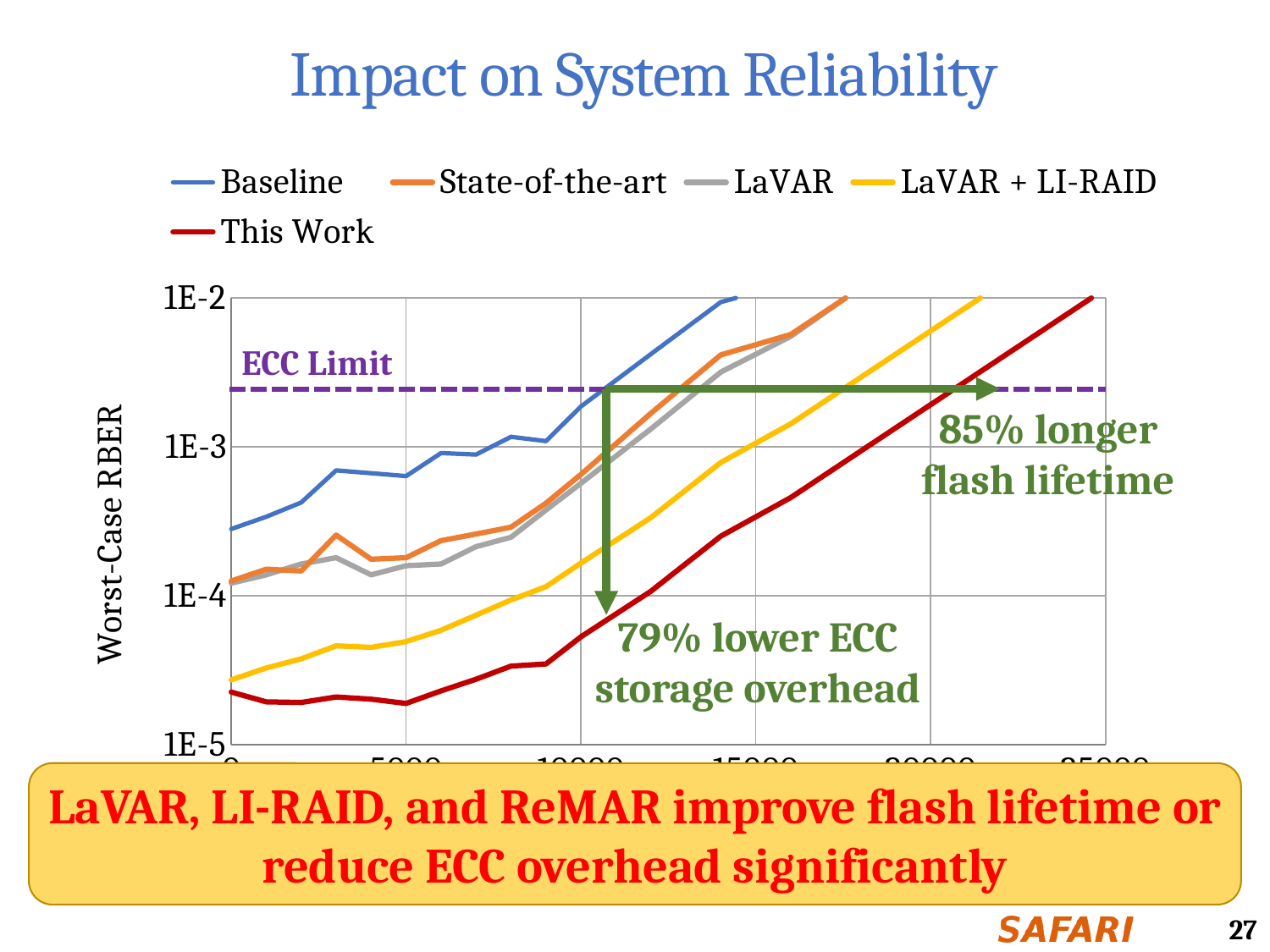
Which series reaches the ECC Limit last (at the largest x value)? This Work Is the Worst-Case RBER of the This Work series at x = 0 greater or less than 1E-4? less Which series has the lowest Worst-Case RBER across the chart? This Work What kind of chart is shown on the slide? Line chart What is the title of the chart on the slide? Impact on System Reliability Do the Worst-Case RBER values rise or fall as the x axis increases? rise Which series has the highest Worst-Case RBER at the left edge of the chart (x = 0)? Baseline How many series does the legend list? 5 Which series reaches the ECC Limit first (at the smallest x value)? Baseline Which series has a higher Worst-Case RBER at x = 0: LaVAR + LI-RAID or This Work? LaVAR + LI-RAID Is the Worst-Case RBER of the Baseline series at x = 0 greater or less than 1E-4? greater What is the label of the y axis? Worst-Case RBER